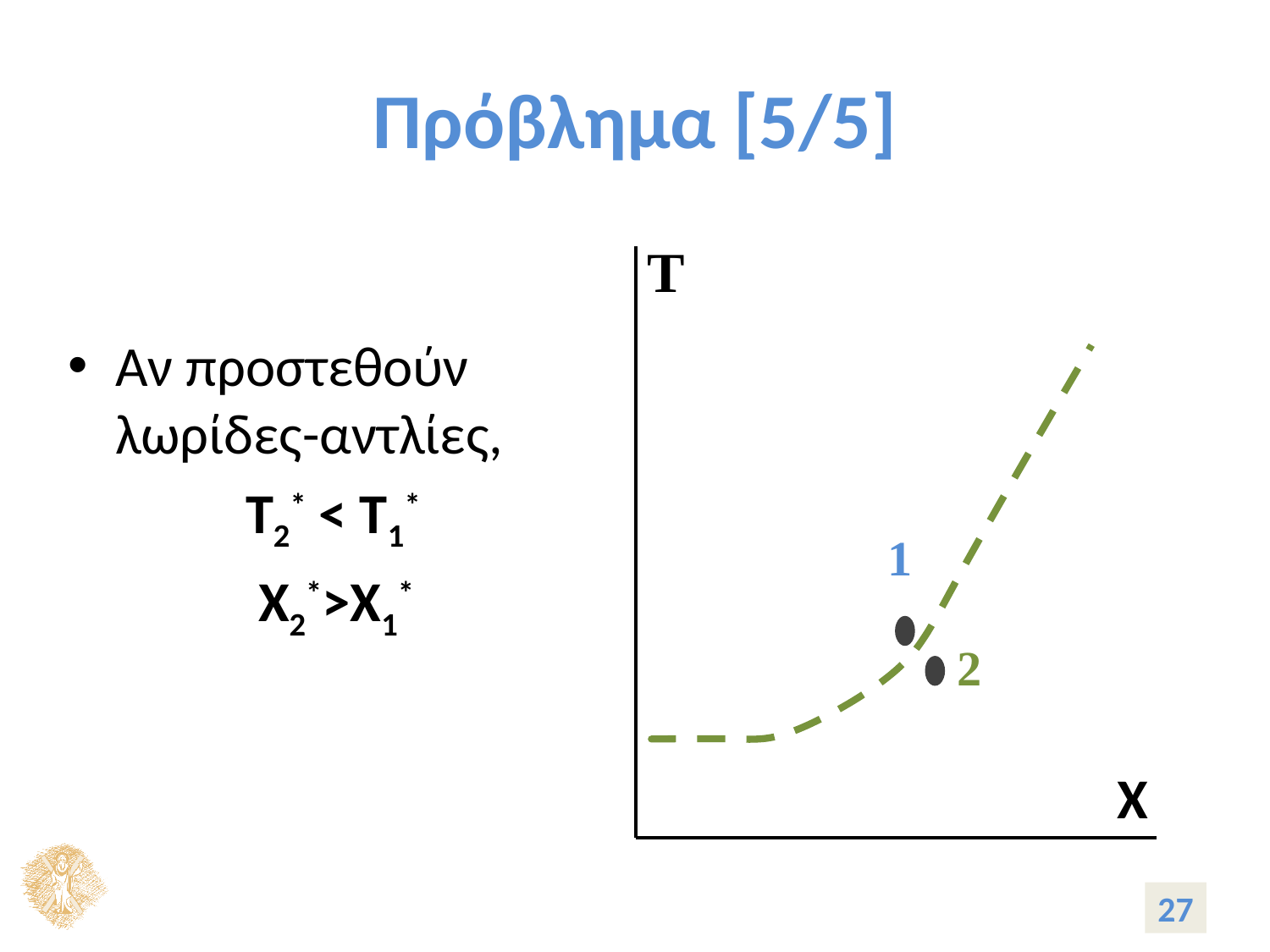
What label is on the horizontal axis of the chart? X Which marked point has the higher T value, point 1 or point 2? point 1 How many marked points are shown on the chart? 2 Which marked point has the larger X value, point 1 or point 2? point 2 Is the dashed curve drawn as a solid or dashed line? dashed What kind of chart is shown on the slide? line chart What label is on the vertical axis of the chart? T Does the dashed curve rise or fall as X increases? rises